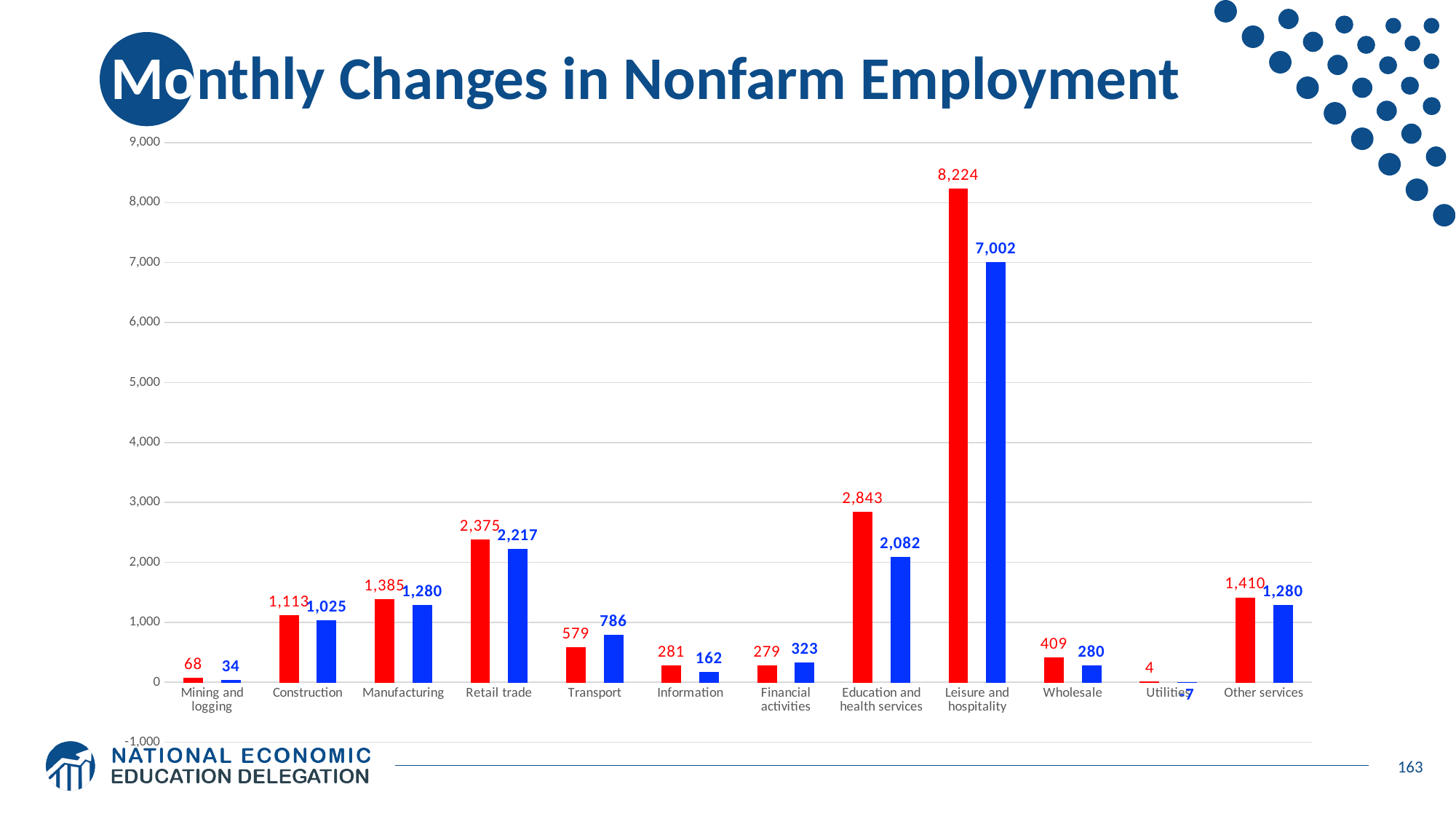
What is the value of the red bar for Leisure and hospitality? 8,224 For Transport, which bar is larger, the red or the blue? blue Which category has the highest red bar? Leisure and hospitality Which category has the lowest red bar? Utilities What type of chart is shown on the slide? bar chart What is the value of the blue bar for Education and health services? 2,082 What is the difference between the red and blue bars for Leisure and hospitality? 1,222 What is the value of the red bar for Utilities? 4 Is the red bar for Education and health services greater or less than 2,000? greater What is the value of the blue bar for Transport? 786 How many categories are shown on the x axis? 12 What is the difference between the red and blue bars for Retail trade? 158